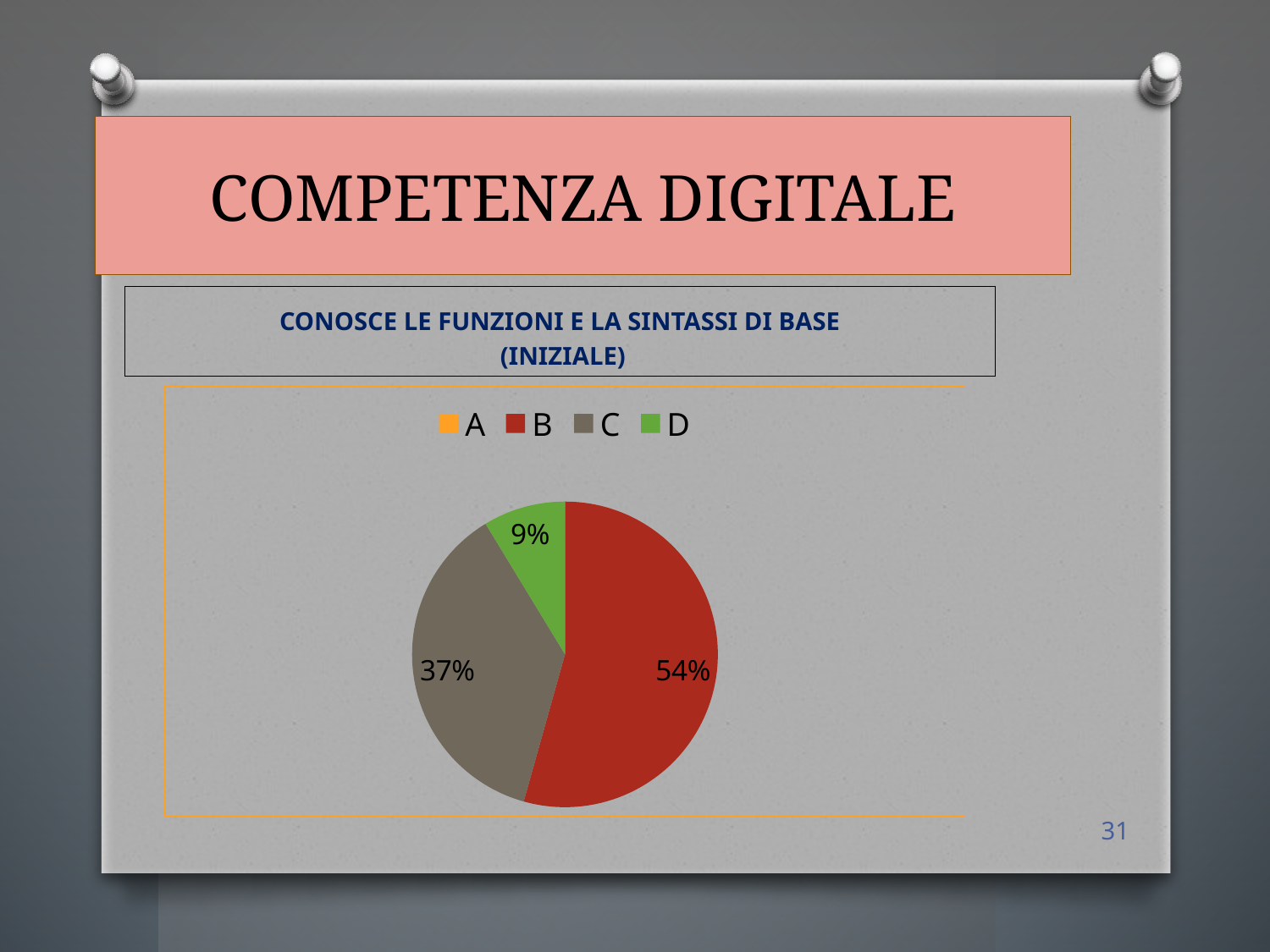
What type of chart is shown on the slide? Pie chart Which category has the largest slice of the pie chart? B What percentage of the pie chart does category C represent? 37% What colour represents category B in the pie chart? Red What is the text in the box directly above the chart? CONOSCE LE FUNZIONI E LA SINTASSI DI BASE (INIZIALE) What percentage of the pie chart does category D represent? 9% Which is larger, the slice for category C or the slice for category D? C What is the difference in percentage points between category C and category D? 28 How many categories are listed in the chart legend? 4 What is the difference in percentage points between category B and category C? 17 What percentage of the pie chart does category B represent? 54% Which category has the smallest visible slice of the pie chart? D